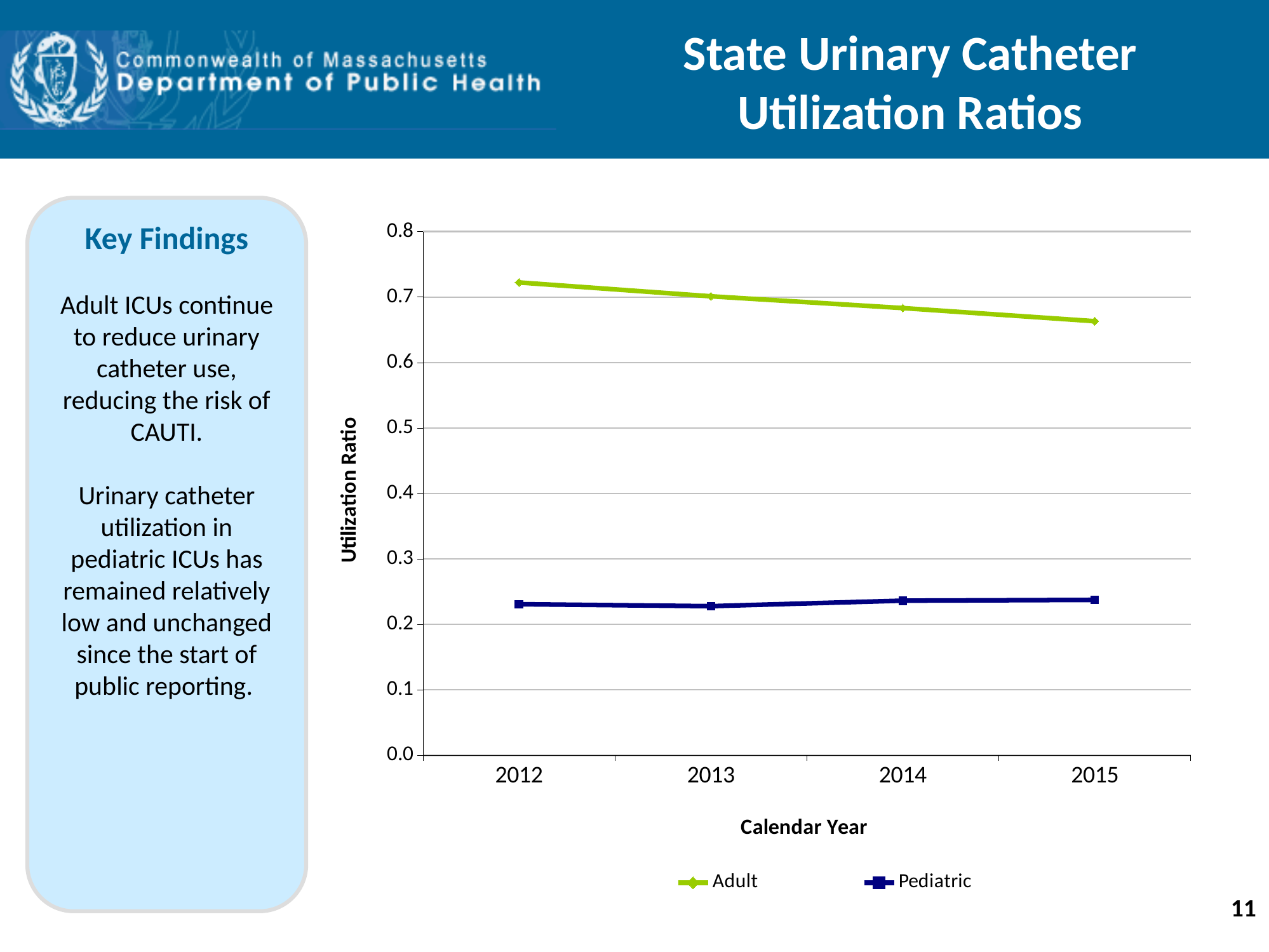
In which year is the Adult utilization ratio highest? 2012 How many calendar years are plotted on the x axis? 4 Is the Adult utilization ratio for 2015 greater or less than 0.7? less Is the Adult utilization ratio for 2012 greater or less than 0.7? greater Which series has the larger utilization ratio in 2014, Adult or Pediatric? Adult Is the Pediatric utilization ratio for 2015 greater or less than 0.3? less What kind of chart is shown on the slide? Line chart What is the title of the y axis? Utilization Ratio Does the Adult utilization ratio rise or fall from 2012 to 2015? Fall In which year is the Adult utilization ratio lowest? 2015 How many series does the chart legend list? 2